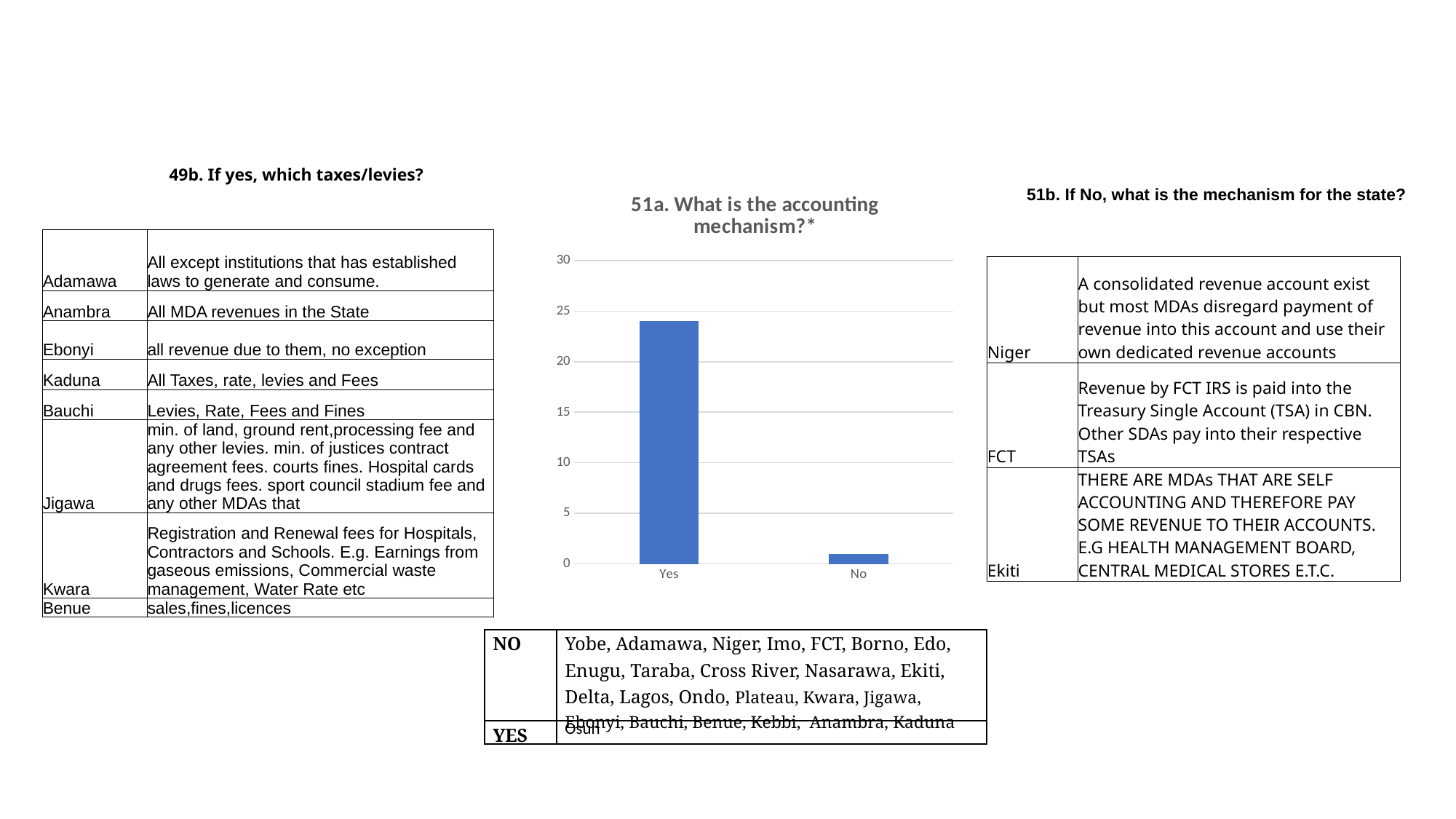
Do the values rise or fall moving from Yes to No along the x axis? fall What kind of chart is shown on the slide? bar chart Is the value for Yes greater or less than 20? greater Which category has the lowest value in the chart? No Is the value for No greater or less than 5? less Which is larger, the value for Yes or the value for No? Yes What is the title of the chart? 51a. What is the accounting mechanism?* What is the highest value shown on the chart's vertical axis? 30 Is the value for Yes greater or less than 25? less Which category has the highest value in the chart? Yes How many categories are plotted on the x axis of the chart? 2